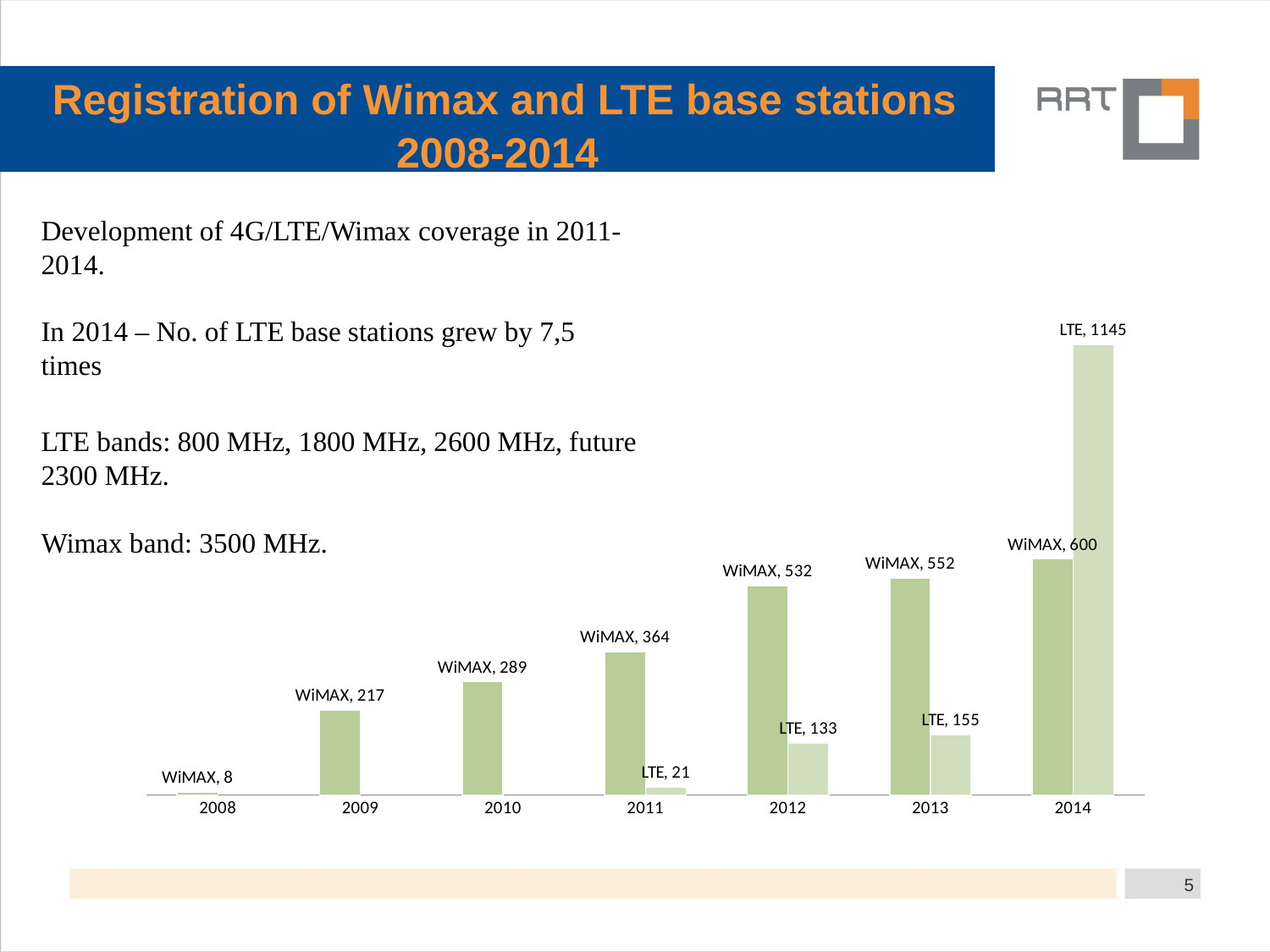
In which year is the WiMAX value highest? 2014 What is the number of WiMAX base stations registered in 2012? 532 What is the WiMAX value for 2008? 8 How many years are shown on the x axis of the chart? 7 Which is larger in 2014, the WiMAX value or the LTE value? LTE In which year is the WiMAX value lowest? 2008 Do the WiMAX values rise or fall from 2008 to 2014? rise What is the difference between the LTE values for 2013 and 2012? 22 What type of chart is shown on the slide? bar chart What is the difference between the WiMAX values for 2014 and 2013? 48 What is the LTE value for 2011? 21 What is the number of LTE base stations registered in 2014? 1145